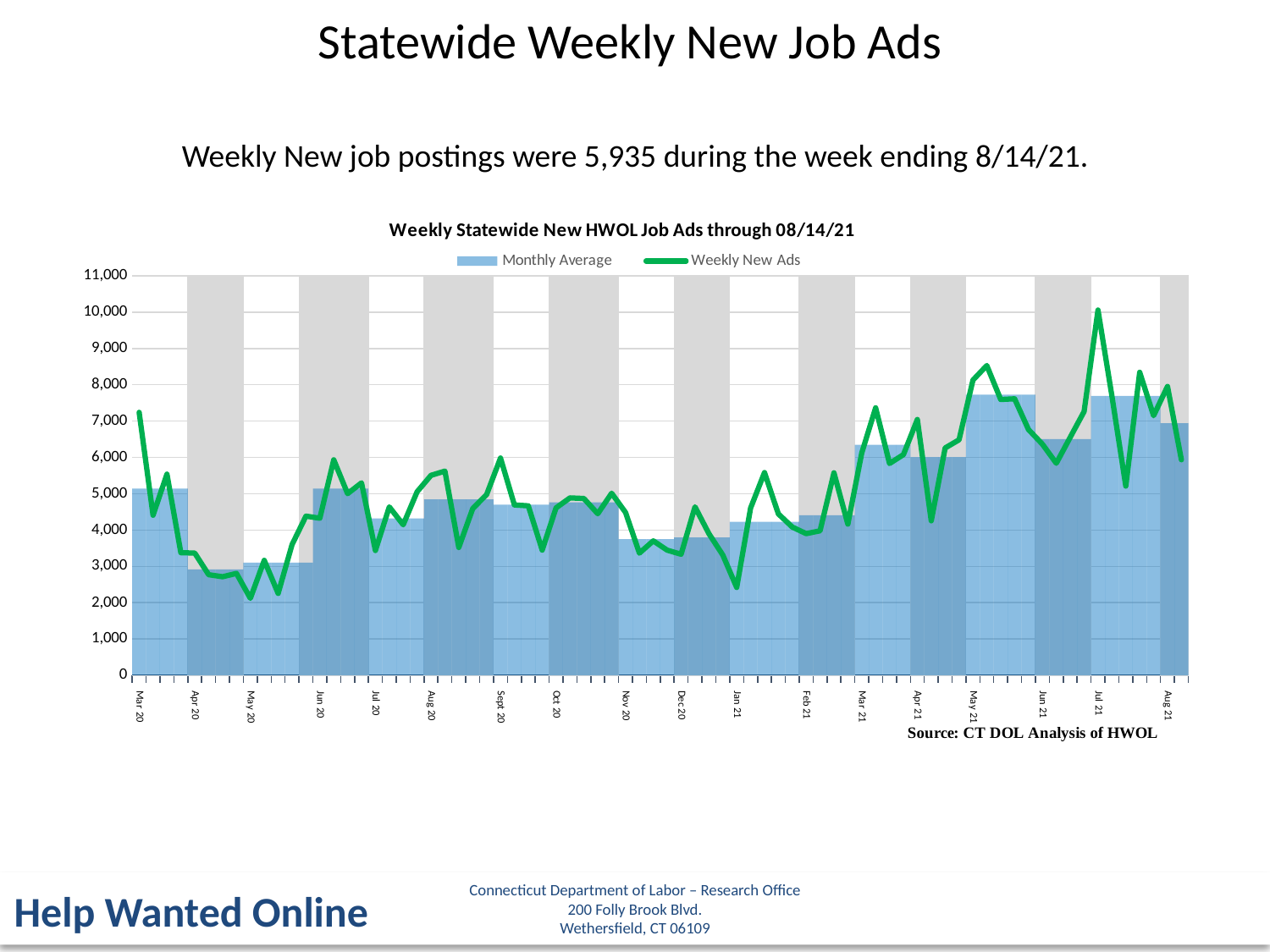
Does the Monthly Average rise or fall from Jan 21 to May 21? Rise Is the peak of the Weekly New Ads line in Jul 21 greater or less than 9,000? greater How many series does the chart legend list? 2 According to the slide, what were weekly new job postings during the week ending 8/14/21? 5,935 In which month does the Weekly New Ads line reach its highest point? Jul 21 Is the Monthly Average bar for Apr 20 greater or less than 4,000? less Is the Monthly Average bar for May 21 greater or less than 7,000? greater What are the two series named in the chart legend? Monthly Average and Weekly New Ads Which has the larger Monthly Average bar, Apr 21 or May 21? May 21 What is the title of the chart? Weekly Statewide New HWOL Job Ads through 08/14/21 How many months are labeled along the x axis of the chart? 18 What kind of chart is shown on the slide? A combined bar and line chart